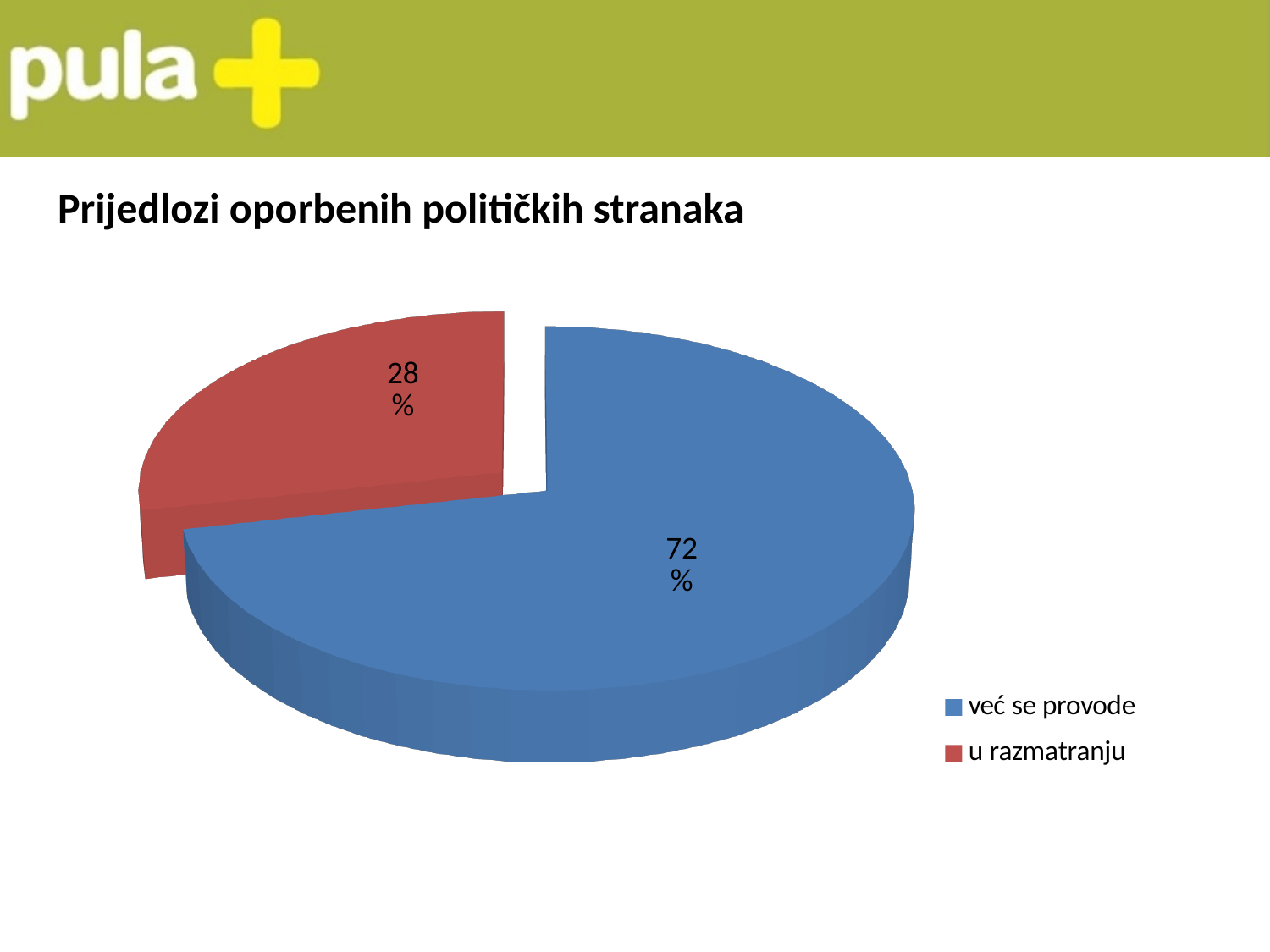
What is the title of the chart? Prijedlozi oporbenih političkih stranaka Which is larger, "već se provode" or "u razmatranju"? već se provode What is the difference in percentage points between "već se provode" and "u razmatranju"? 44 Which slice is the largest? već se provode What colour is the "u razmatranju" slice? red How many slices does the pie chart have? 2 What kind of chart is shown on the slide? pie chart What share of the pie does "u razmatranju" take? 28% How many entries does the legend list? 2 Which slice is the smallest? u razmatranju What share of the pie does "već se provode" take? 72%